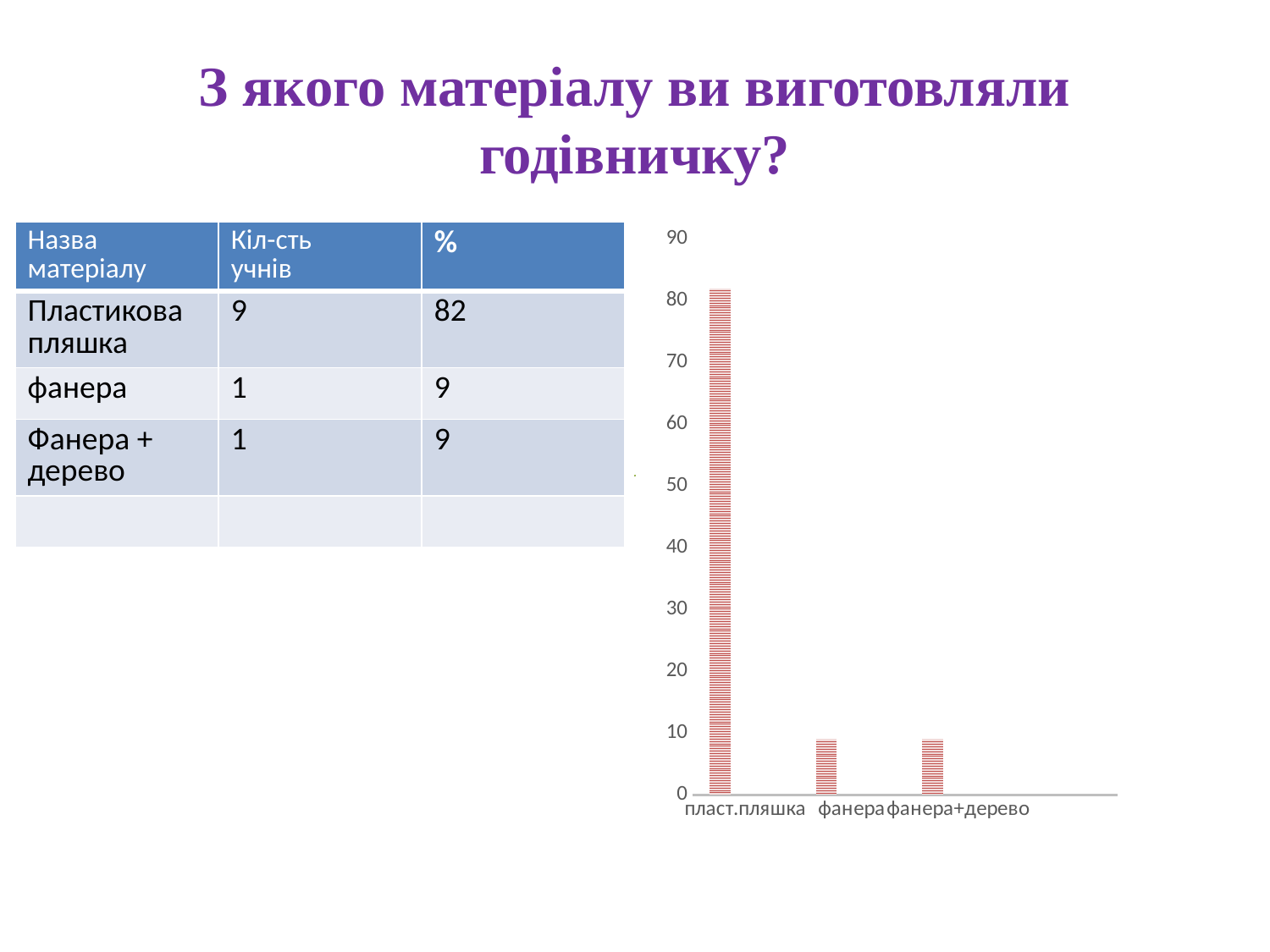
How many categories are shown on the x axis of the chart? 3 What kind of chart is shown on the slide? bar chart Is the value for фанера in the chart greater or less than 20? less Which is larger in the chart, the value for пласт.пляшка or the value for фанера? пласт.пляшка What is the label of the first category on the x axis of the chart? пласт.пляшка Is the value for пласт.пляшка in the chart greater or less than 50? greater Is the value for фанера+дерево in the chart greater or less than 30? less Which category has the highest bar in the chart? пласт.пляшка What is the highest tick value shown on the y axis of the chart? 90